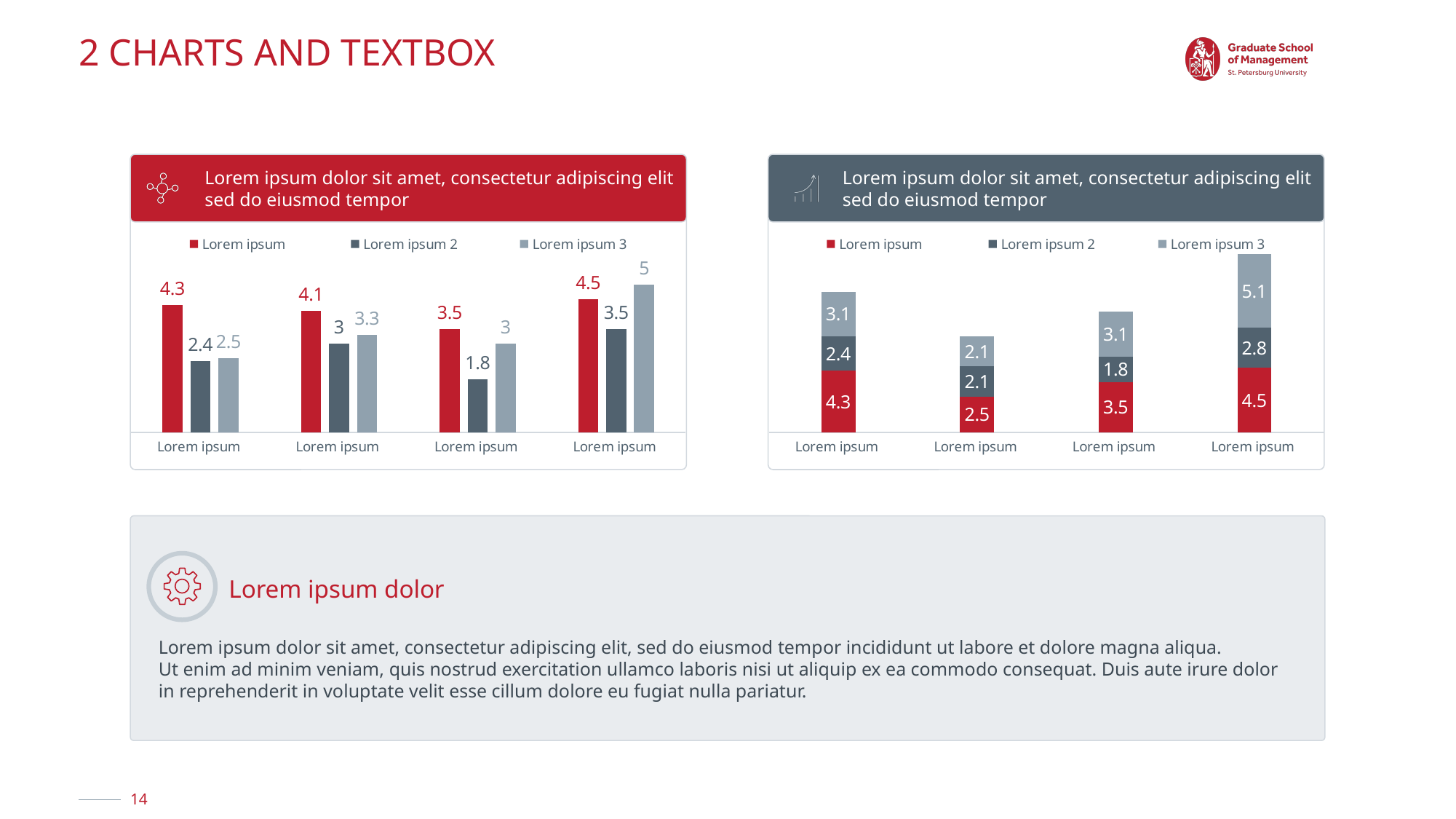
In the left chart, what is the value of the 'Lorem ipsum' series for the first category? 4.3 In the left chart, what is the value of the 'Lorem ipsum 2' series for the third category? 1.8 In the right chart, what is the total of the stacked bar for the first category? 9.8 In the right chart, which category has the tallest stacked bar? the fourth category How many categories are shown on the x axis of the right chart? 4 In the left chart, what is the difference between the 'Lorem ipsum' and 'Lorem ipsum 2' values in the second category? 1.1 In the right chart, what is the value of the 'Lorem ipsum 3' segment in the fourth category? 5.1 What type of chart is the chart on the left of the slide? bar chart In the left chart, which is larger in the third category: 'Lorem ipsum 2' or 'Lorem ipsum 3'? Lorem ipsum 3 How many series does the legend of the left chart list? 3 In the left chart, which series has the highest value in the fourth category? Lorem ipsum 3 What type of chart is the chart on the right of the slide? stacked bar chart